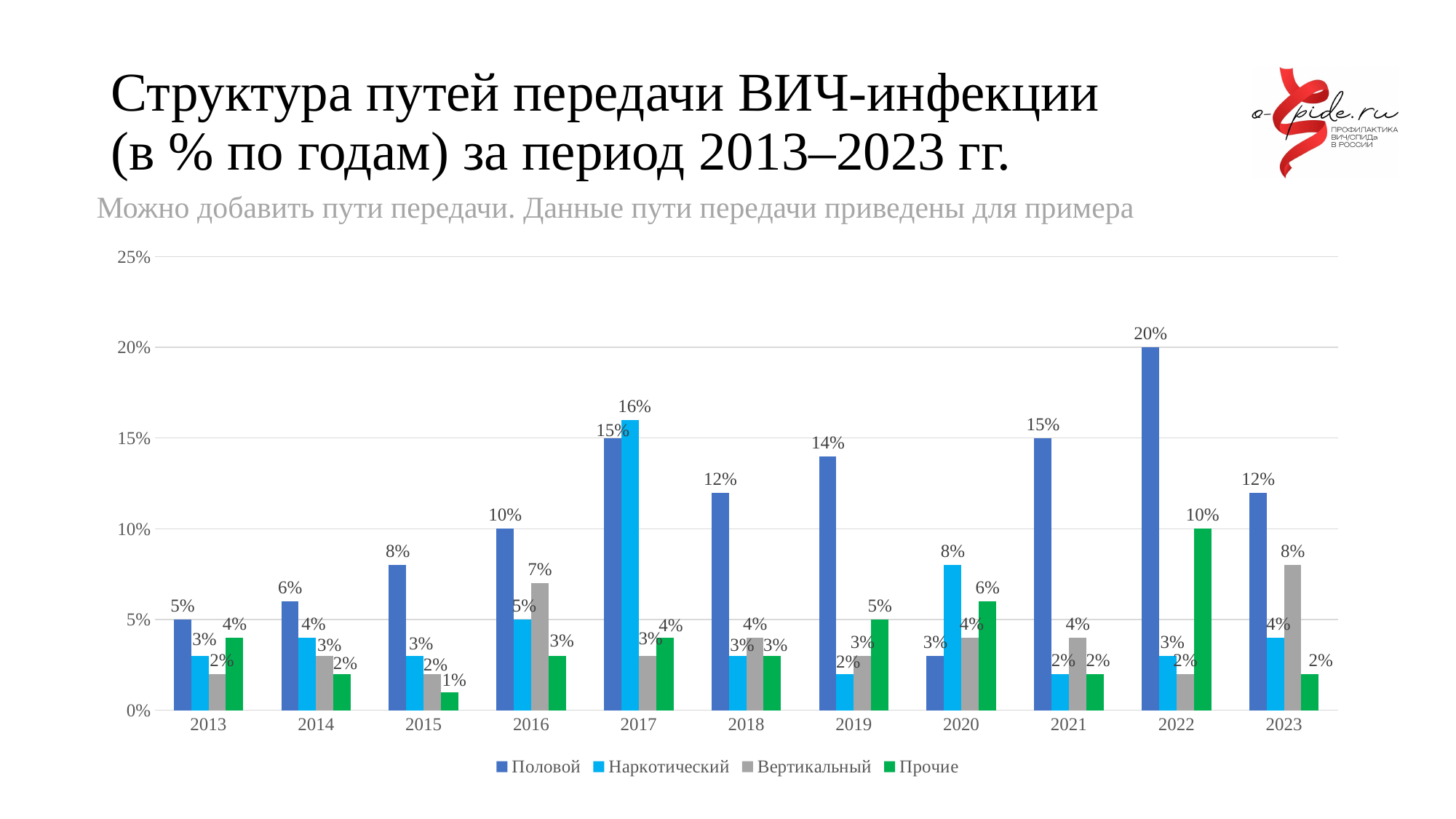
What is the difference between the Половой values in 2022 and 2023? 8% What is the value for Наркотический in 2020? 8% How many years are shown on the x axis? 11 What kind of chart is shown on the slide? Bar chart Is the value for Половой in 2019 greater or less than 10%? greater What is the value for Половой in 2022? 20% How many series does the legend list? 4 Which is larger in 2017: Половой or Наркотический? Наркотический In which year is the Прочие value lowest? 2015 What is the value for Прочие in 2015? 1% In which year is the Половой value highest? 2022 What is the value for Вертикальный in 2016? 7%